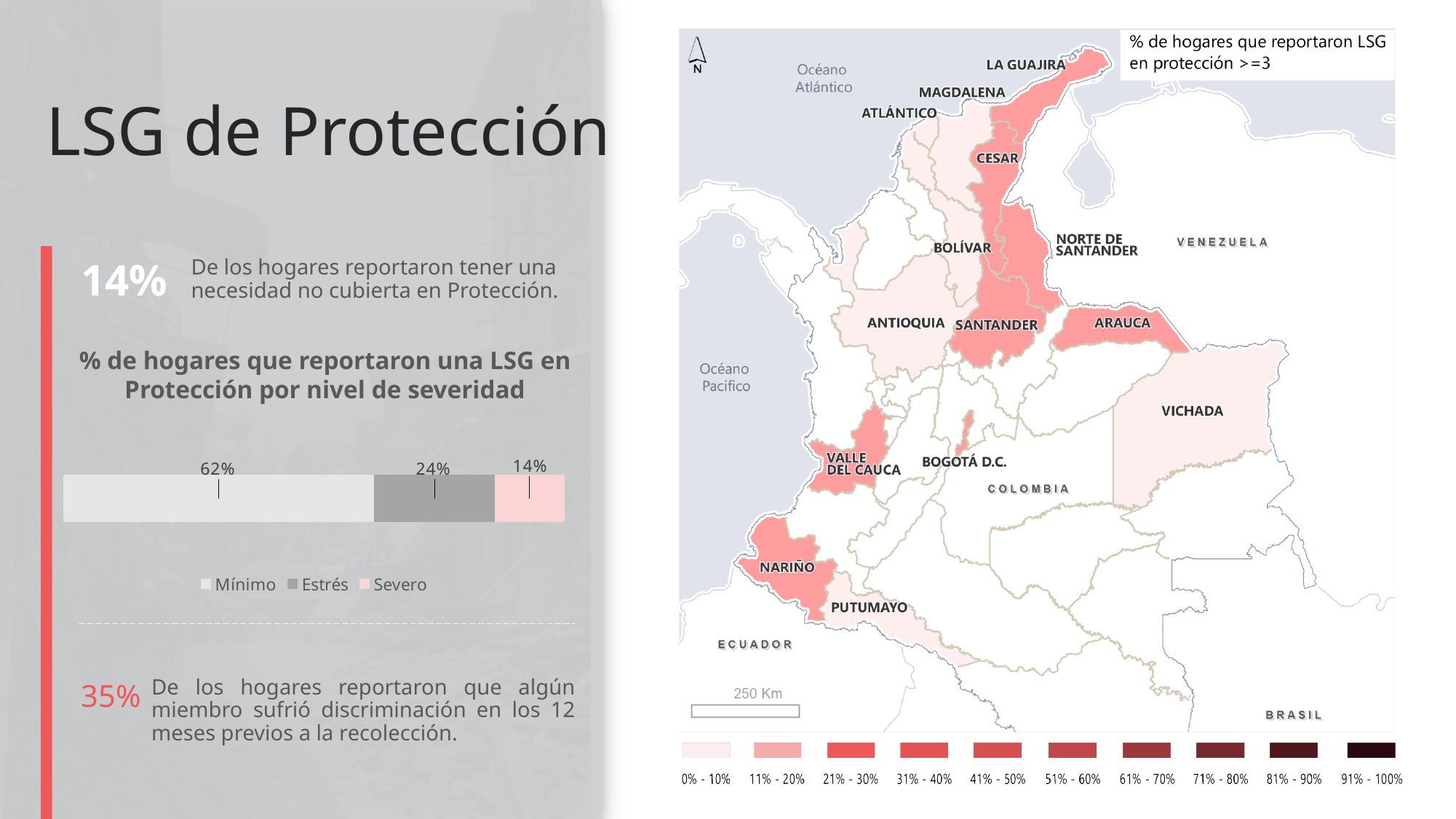
In the chart '% de hogares que reportaron una LSG en Protección por nivel de severidad', which severity level has the lowest value? Severo In the map on the right, what range does the lightest colour in the legend represent? 0% - 10% In the chart '% de hogares que reportaron una LSG en Protección por nivel de severidad', which is larger, Estrés or Severo? Estrés In the chart '% de hogares que reportaron una LSG en Protección por nivel de severidad', which severity level has the highest value? Mínimo In the chart '% de hogares que reportaron una LSG en Protección por nivel de severidad', what is the difference between the Estrés and Severo values? 10% In the chart '% de hogares que reportaron una LSG en Protección por nivel de severidad', what is the total of the three segments of the stacked bar? 100% In the chart '% de hogares que reportaron una LSG en Protección por nivel de severidad', what is the value for Estrés? 24% How many series does the legend of the chart '% de hogares que reportaron una LSG en Protección por nivel de severidad' list? 3 In the chart '% de hogares que reportaron una LSG en Protección por nivel de severidad', what is the difference between the Mínimo and Estrés values? 38% What kind of chart is '% de hogares que reportaron una LSG en Protección por nivel de severidad'? Stacked bar chart In the chart '% de hogares que reportaron una LSG en Protección por nivel de severidad', what is the value for Severo? 14% In the chart '% de hogares que reportaron una LSG en Protección por nivel de severidad', what is the value for Mínimo? 62%